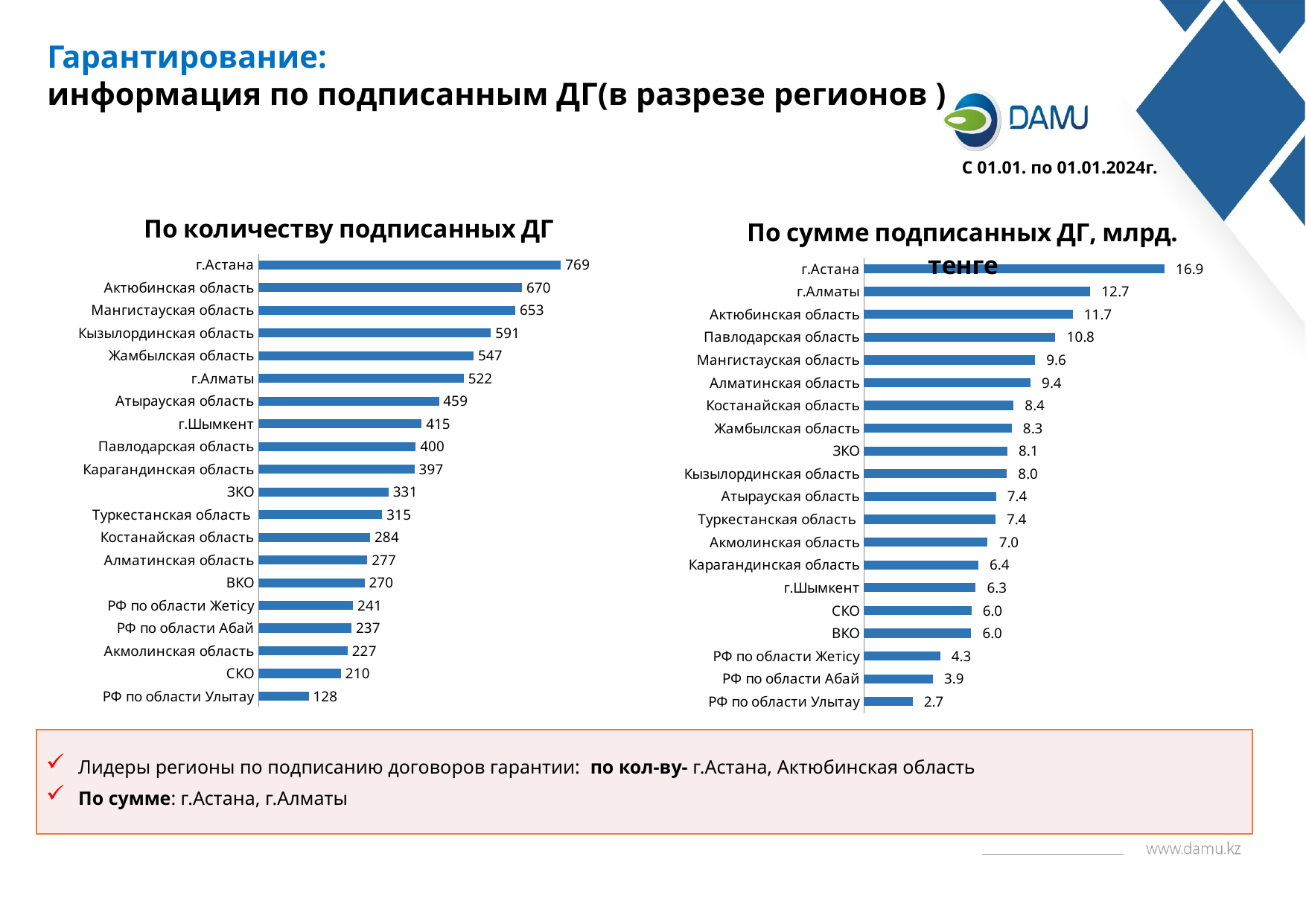
In the chart 'По сумме подписанных ДГ, млрд. тенге', what is the value for ВКО? 6.0 In the chart 'По сумме подписанных ДГ, млрд. тенге', which is larger: г.Алматы or Актюбинская область? г.Алматы In the chart 'По сумме подписанных ДГ, млрд. тенге', what is the difference between г.Астана and г.Алматы? 4.2 In the chart 'По количеству подписанных ДГ', which is larger: г.Шымкент or Павлодарская область? г.Шымкент In the chart 'По сумме подписанных ДГ, млрд. тенге', what is the value for Павлодарская область? 10.8 What type of chart is 'По сумме подписанных ДГ, млрд. тенге'? bar chart In the chart 'По количеству подписанных ДГ', what is the difference between г.Астана and Актюбинская область? 99 In the chart 'По количеству подписанных ДГ', what is the value for Кызылординская область? 591 In the chart 'По количеству подписанных ДГ', which region has the highest value? г.Астана In the chart 'По количеству подписанных ДГ', which region has the lowest value? РФ по области Улытау In the chart 'По сумме подписанных ДГ, млрд. тенге', which region has the lowest value? РФ по области Улытау In the chart 'По количеству подписанных ДГ', how many regions are shown? 20